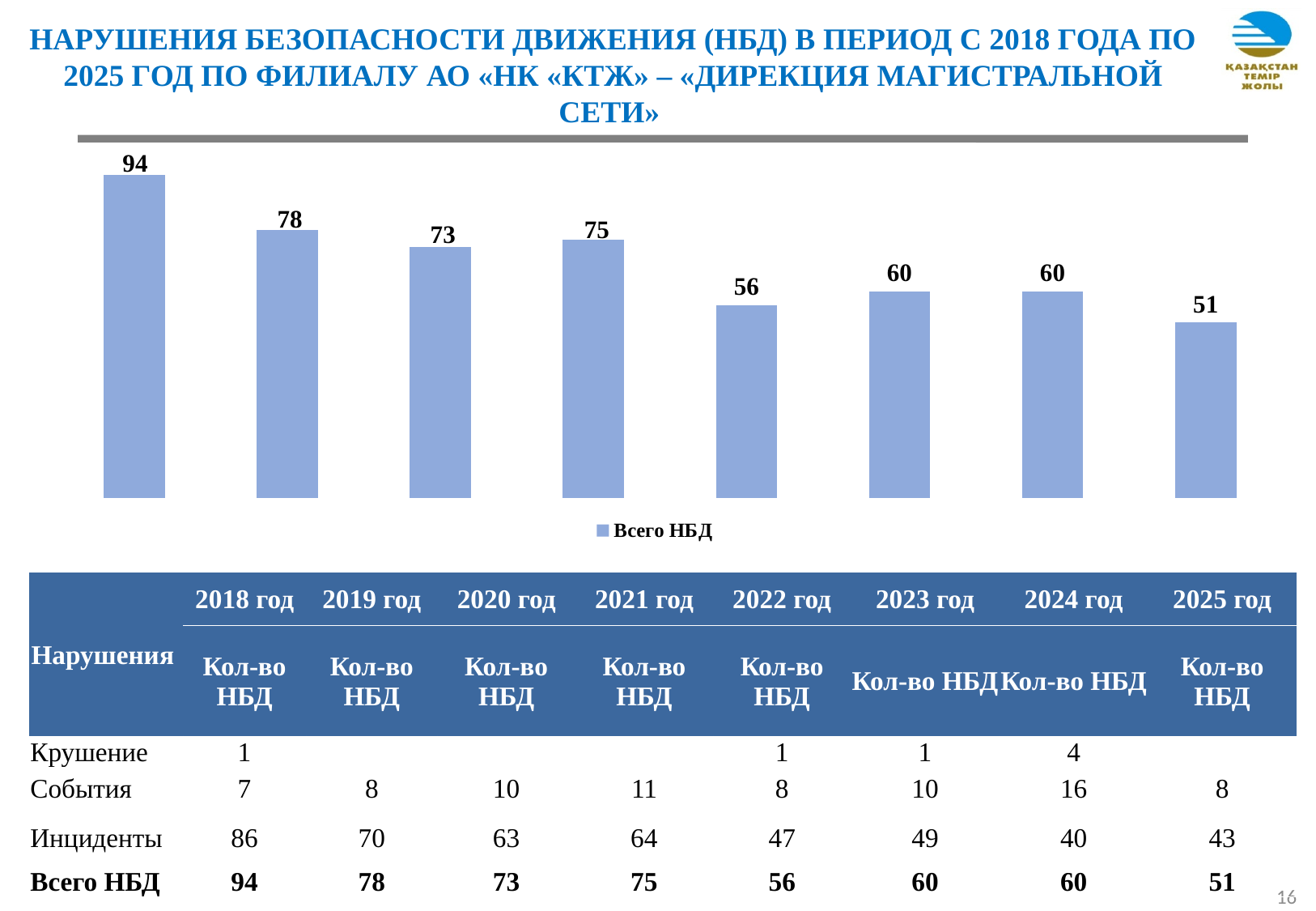
How many series does the chart legend list? 1 Overall, do the bar values rise or fall from left to right across the chart? fall Which bar has the highest value in the chart? the first bar (2018), 94 Which is larger: the third bar (2020) or the fourth bar (2021)? the fourth bar (2021), 75 How many bars are plotted in the chart? 8 What type of chart is shown on the slide? bar chart What is the difference between the first bar (94) and the last bar (51)? 43 What is the name of the series shown in the chart legend? Всего НБД What is the value of the last (rightmost) bar, corresponding to 2025? 51 What is the value of the fifth bar, corresponding to 2022? 56 What is the value of the first (leftmost) bar, corresponding to 2018? 94 Which bar has the lowest value in the chart? the last bar (2025), 51